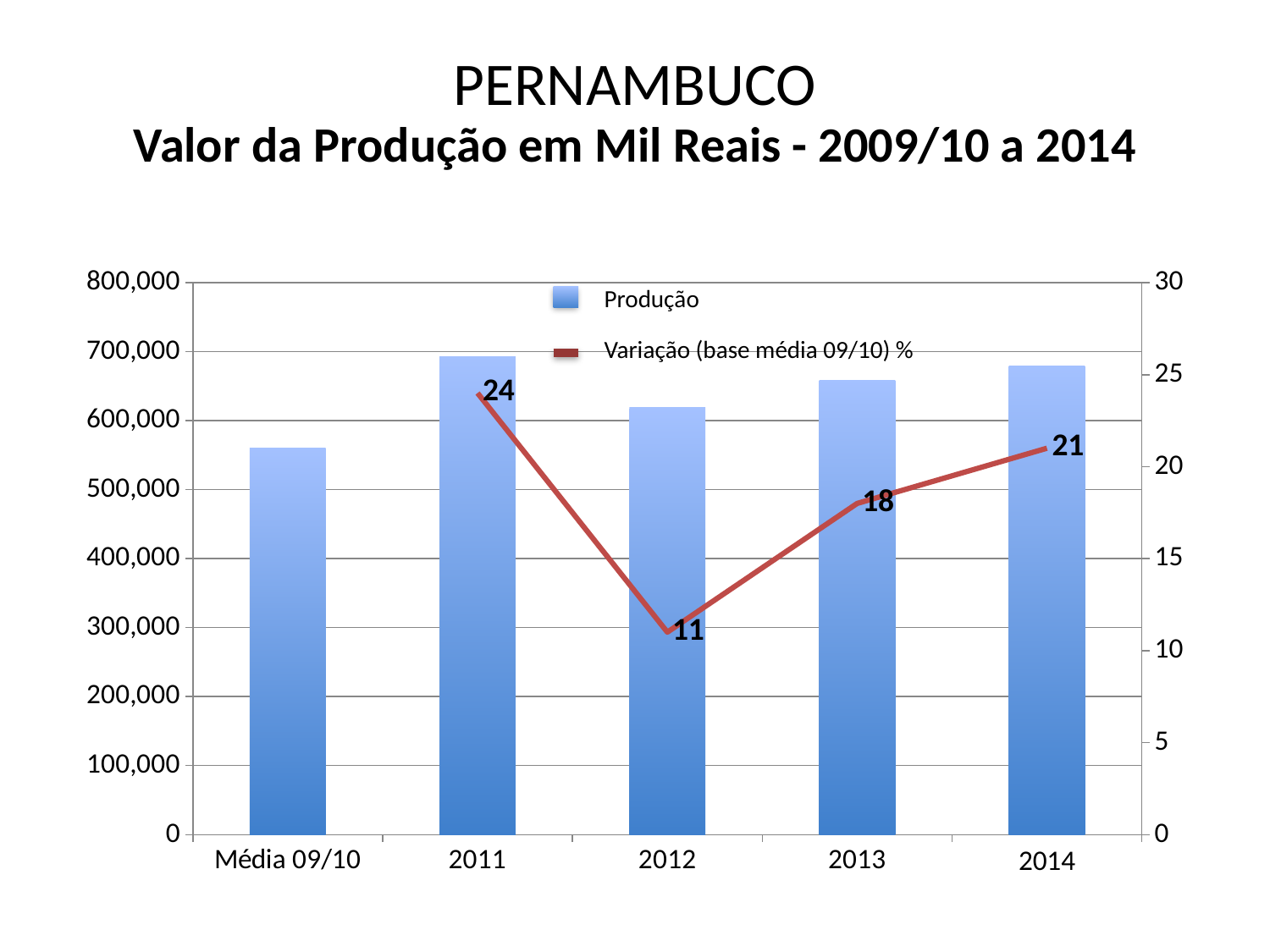
What is the value of Variação (base média 09/10) % for 2014? 21 Does the Variação (base média 09/10) % line rise or fall from 2012 to 2014? rise Is the Produção value for Média 09/10 greater or less than 600,000? less What is the difference between the Variação (base média 09/10) % for 2011 and 2012? 13 Which year has the lowest Variação (base média 09/10) %? 2012 How many series does the legend list? 2 Which year has the highest Variação (base média 09/10) %? 2011 Which year has the taller Produção bar, 2011 or 2012? 2011 Is the Produção value for 2014 greater or less than 600,000? greater What is the value of Variação (base média 09/10) % for 2011? 24 How many categories are shown on the x axis? 5 What is the value of Variação (base média 09/10) % for 2012? 11